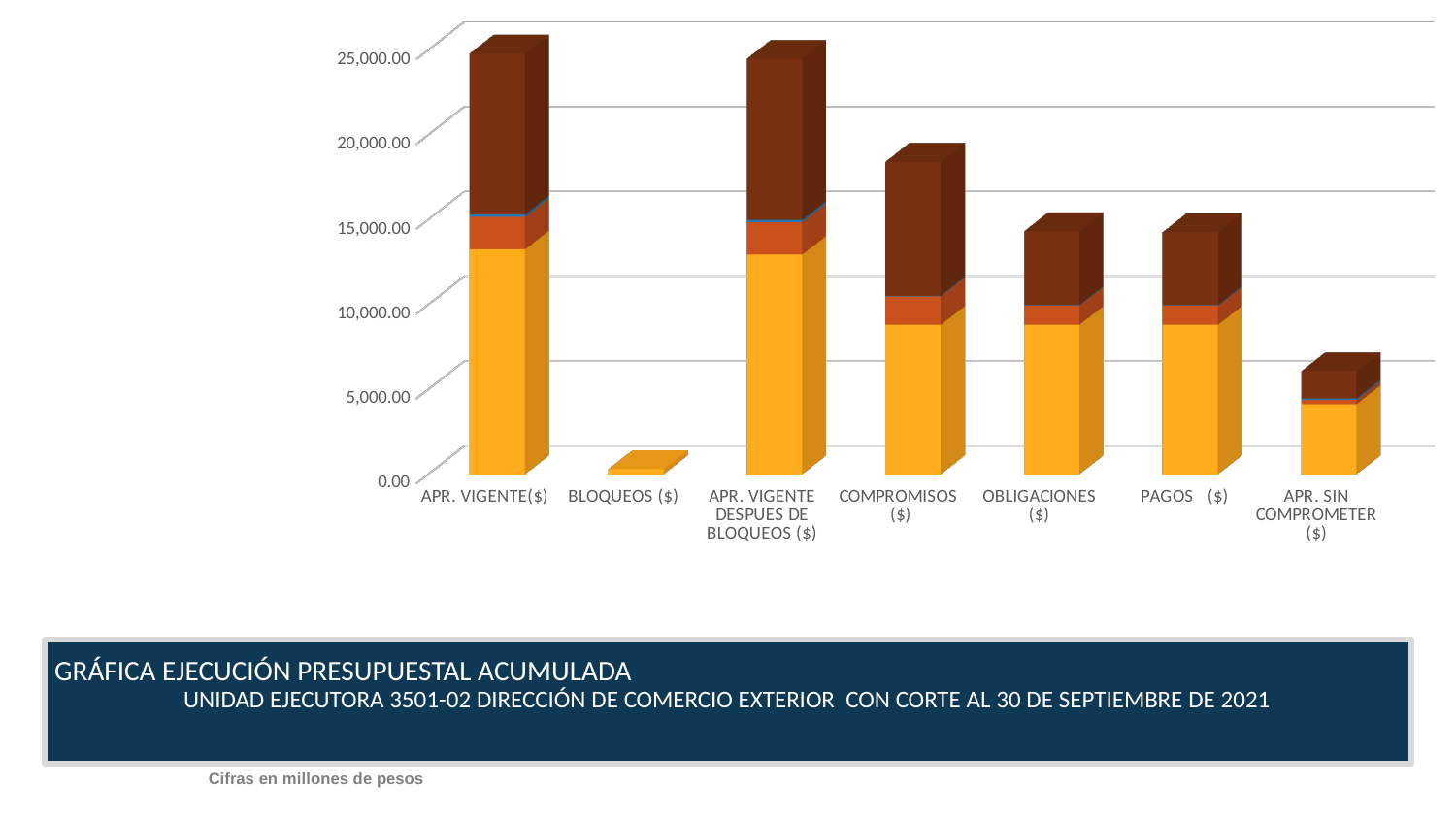
Which has a larger total bar, COMPROMISOS ($) or OBLIGACIONES ($)? COMPROMISOS ($) Is the total value for APR. VIGENTE($) greater or less than 20,000.00? greater What kind of chart is shown on the slide? Stacked bar chart Is the total value for BLOQUEOS ($) greater or less than 5,000.00? less Which category has the lowest total bar in the chart? BLOQUEOS ($) How many categories are shown on the x axis of the chart? 7 Is the total value for COMPROMISOS ($) greater or less than 20,000.00? less Which has a larger total bar, APR. VIGENTE($) or COMPROMISOS ($)? APR. VIGENTE($) According to the note below the chart, in what units are the figures expressed? Millones de pesos What is the highest value labelled on the vertical axis of the chart? 25,000.00